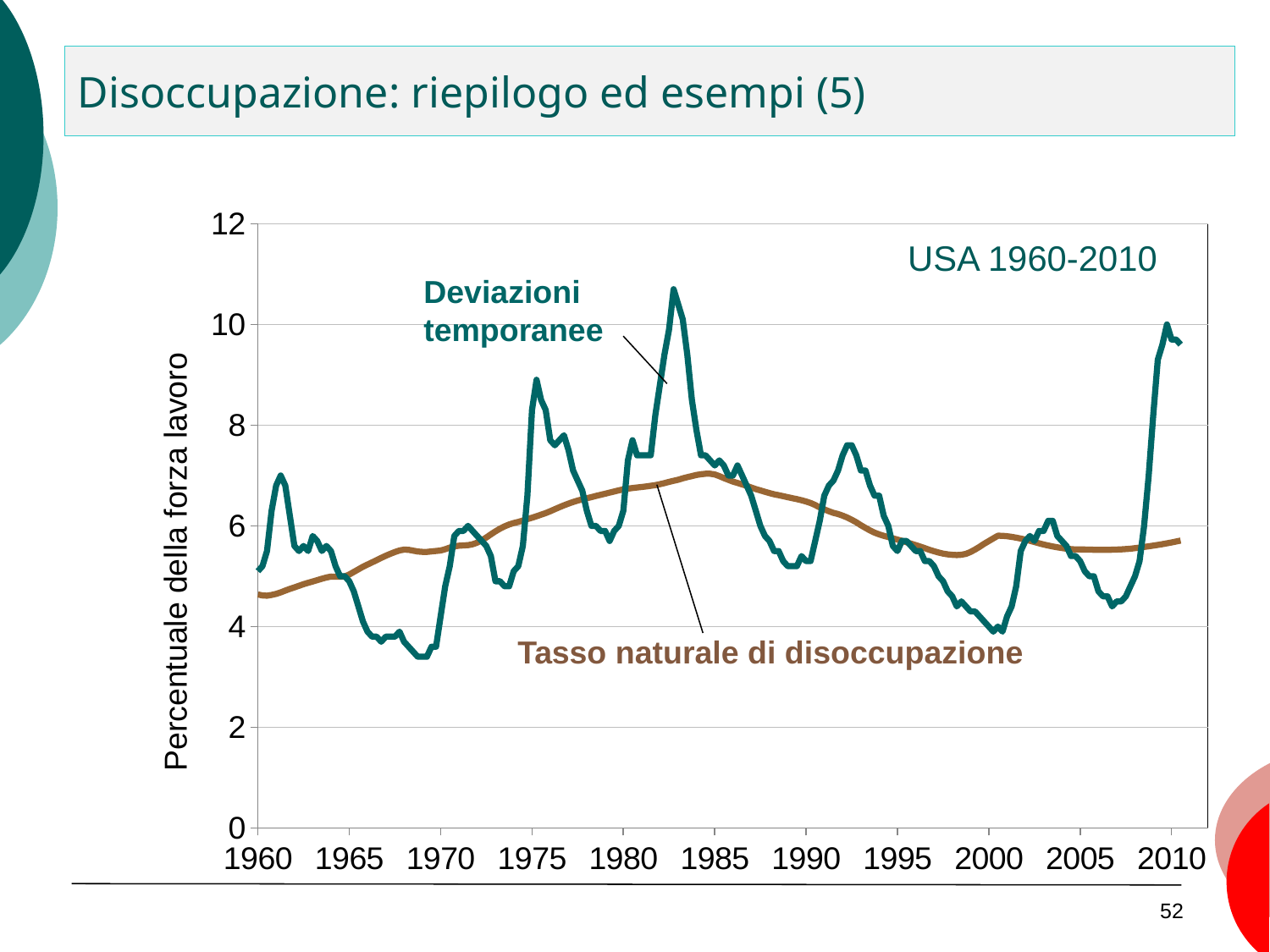
Is the peak of the 'Deviazioni temporanee' line around 1983 greater or less than 10? greater Is the value of the 'Deviazioni temporanee' line in 2010 greater or less than 8? greater Around 1983, which line is higher: 'Deviazioni temporanee' or 'Tasso naturale di disoccupazione'? Deviazioni temporanee What is the label on the vertical axis of the chart? Percentuale della forza lavoro How many data series are plotted on the chart? 2 What is the highest value shown on the vertical axis? 12 Which country and period does the chart cover, according to the text in the plot area? USA 1960-2010 Is the value of the 'Tasso naturale di disoccupazione' line in 1960 greater or less than 6? less What kind of chart is shown on the slide? line chart Does the 'Tasso naturale di disoccupazione' line rise or fall between 1985 and 2000? fall Does the 'Tasso naturale di disoccupazione' line rise or fall between 1960 and 1985? rise